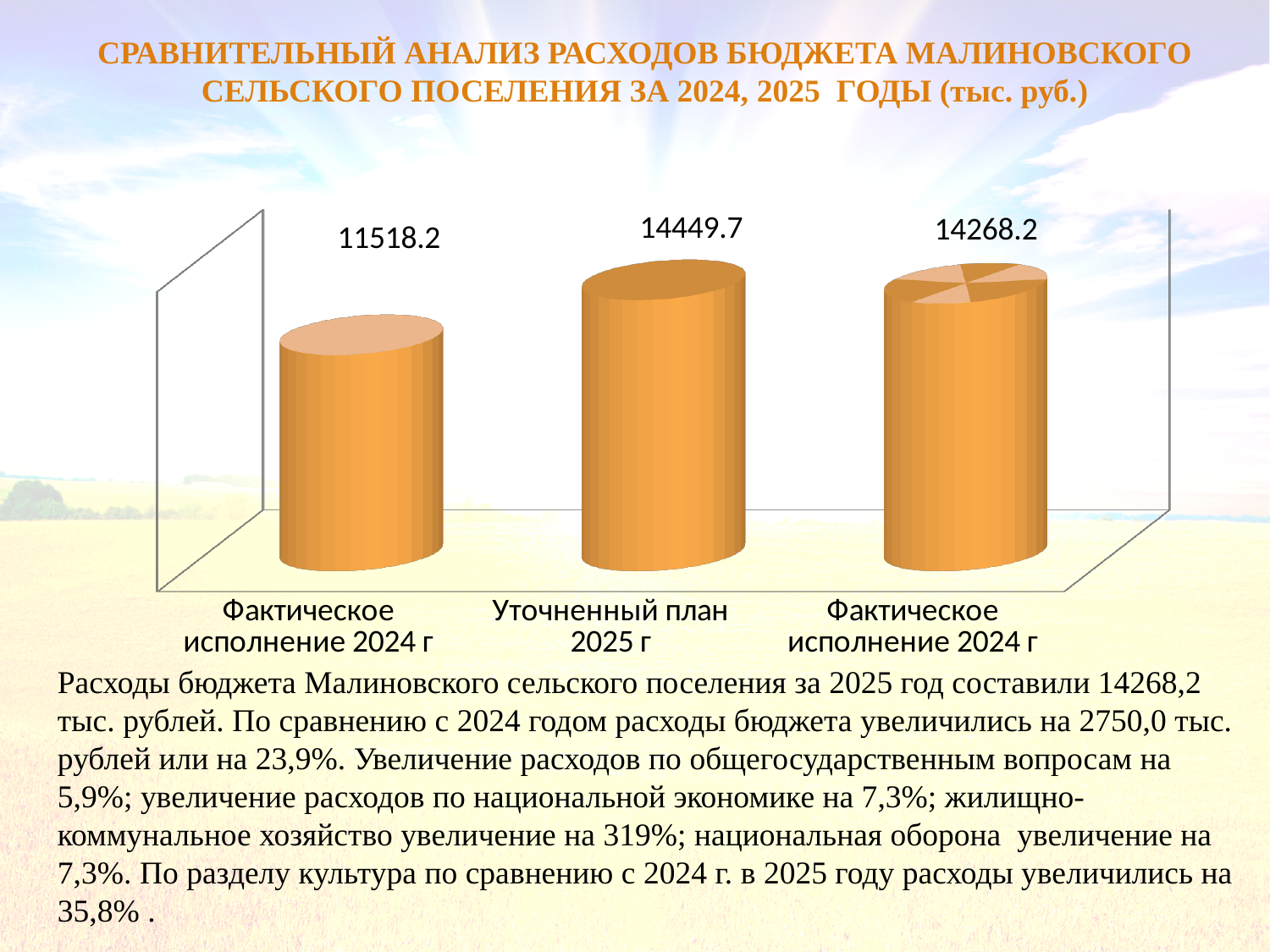
Which category has the highest value in the chart? Уточненный план 2025 г What value is shown for the rightmost bar in the chart? 14268.2 What kind of chart is shown on the slide? Bar chart What value is shown for the leftmost bar, "Фактическое исполнение 2024 г"? 11518.2 Which is larger: the value for "Уточненный план 2025 г" or the value of the leftmost bar? Уточненный план 2025 г Which bar has the lowest value in the chart? The leftmost bar, Фактическое исполнение 2024 г (11518.2) What colour are the bars in the chart? Orange What is the difference between the value for "Уточненный план 2025 г" and the rightmost bar's value? 181.5 What value is shown for "Уточненный план 2025 г"? 14449.7 What unit of measurement is stated in the slide title for the chart values? тыс. руб. What is the difference between the rightmost bar's value and the leftmost bar's value? 2750.0 How many bars are plotted in the chart? 3